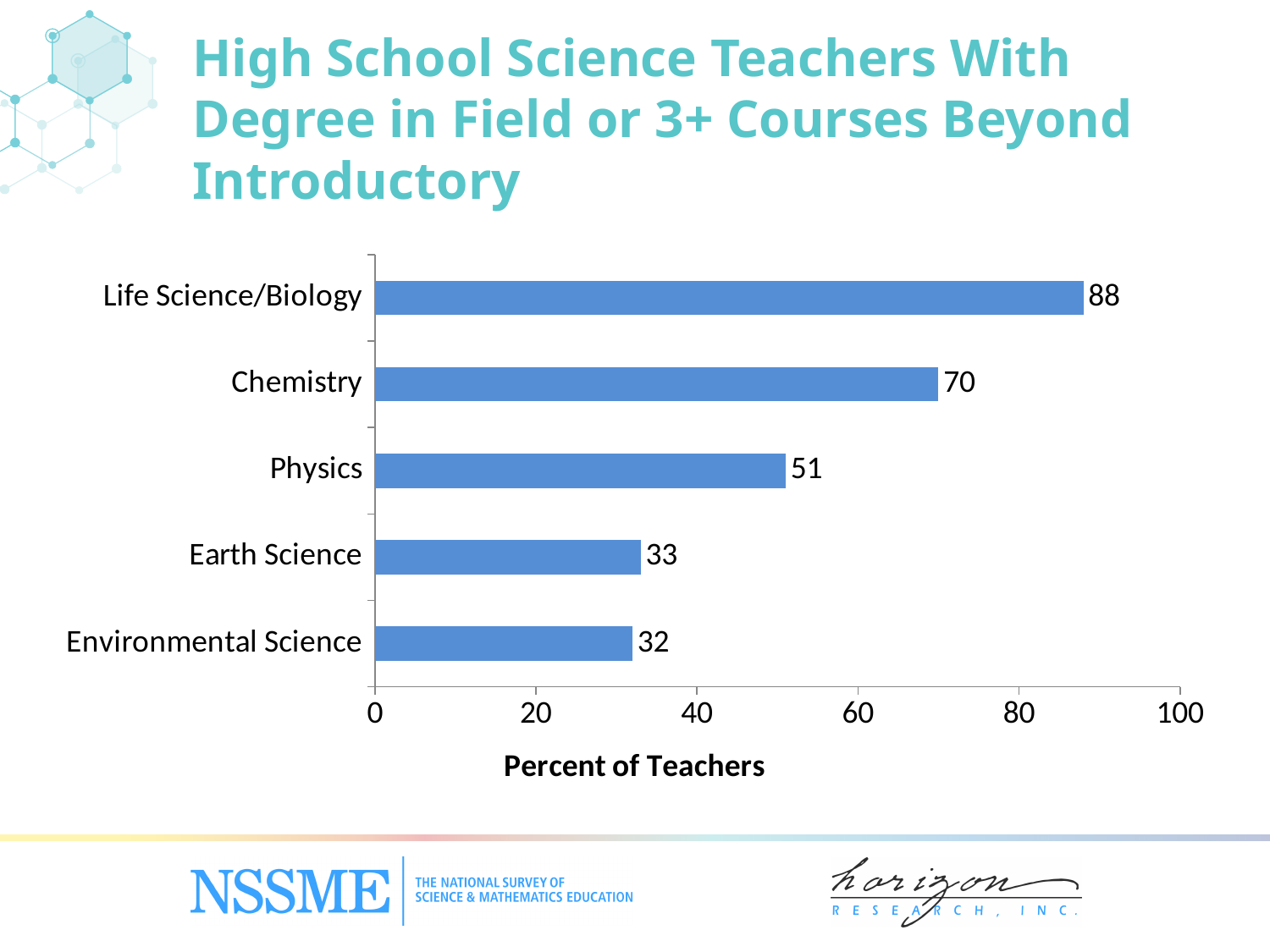
What is the value for Life Science/Biology? 88 Which category has the highest value? Life Science/Biology What is the value for Chemistry? 70 What is the difference between the values for Life Science/Biology and Chemistry? 18 What is the difference between the values for Physics and Earth Science? 18 What is the value for Environmental Science? 32 What kind of chart is shown on the slide? Bar chart What is the value for Physics? 51 What is the label of the horizontal axis? Percent of Teachers Which category has the lowest value? Environmental Science Which is larger, the value for Chemistry or the value for Physics? Chemistry How many categories are shown in the chart? 5